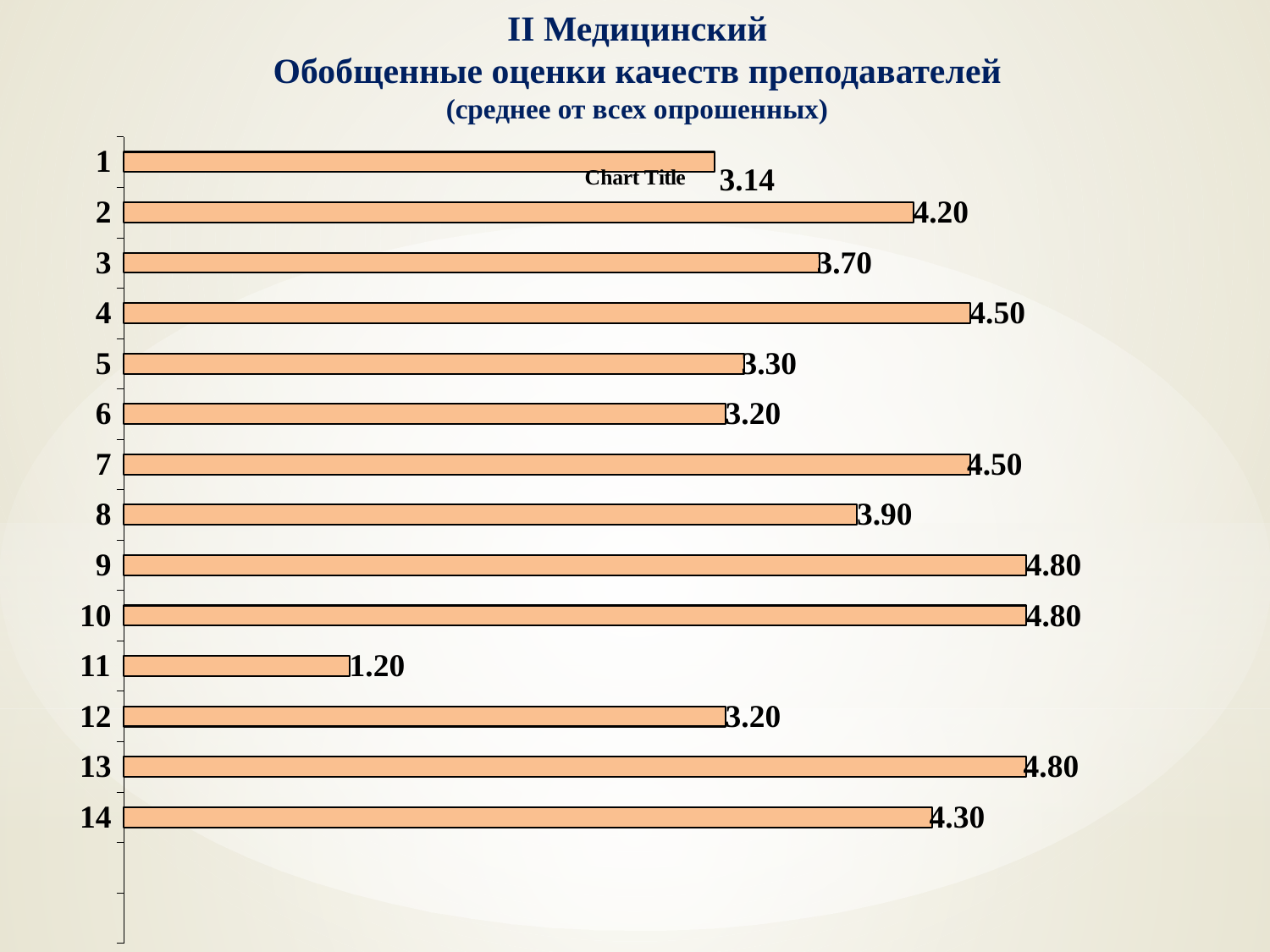
Which category has the lowest value? 11 What is the difference between the values for category 2 and category 3? 0.50 What is the difference between the values for category 9 and category 11? 3.60 What is the highest value shown on the chart? 4.80 What is the value for category 11? 1.20 What kind of chart is shown on the slide? bar chart What is the subtitle in parentheses below the main title of the slide? (среднее от всех опрошенных) Which is larger, the value for category 4 or the value for category 5? category 4 What is the value for category 14? 4.30 What is the value for category 1? 3.14 What is the value for category 8? 3.90 How many categories are plotted on the chart? 14